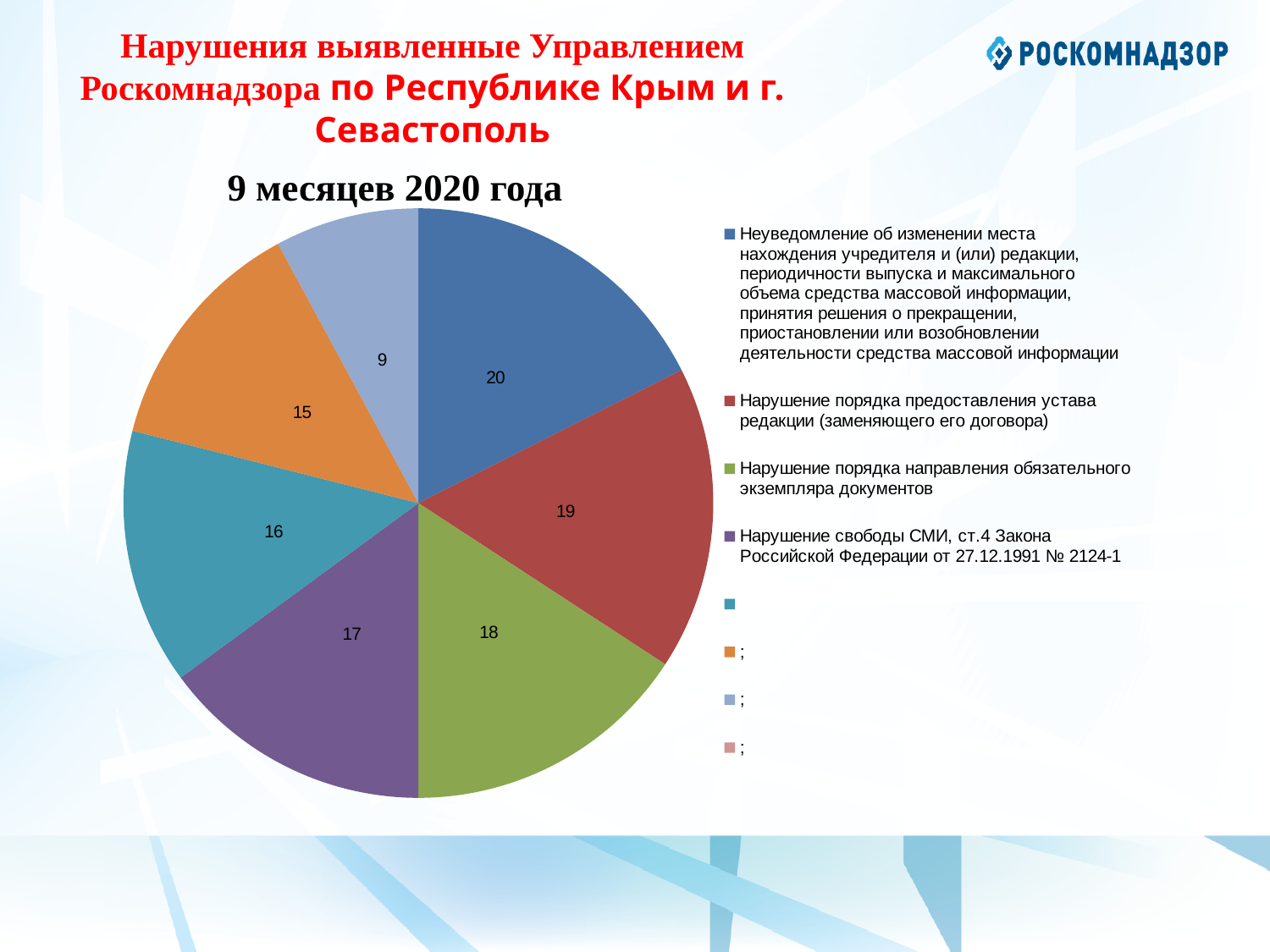
What kind of chart is shown on the slide? Pie chart By how much does the slice for "Нарушение порядка предоставления устава редакции" exceed the slice for "Нарушение свободы СМИ"? 2 What is the value of the slice for "Нарушение порядка направления обязательного экземпляра документов"? 18 How many slices with data labels does the pie chart have? 7 What is the title of the pie chart? 9 месяцев 2020 года What is the largest value shown on the pie chart? 20 What is the value of the slice for "Неуведомление об изменении места нахождения учредителя и (или) редакции..."? 20 What is the value of the slice for "Нарушение свободы СМИ, ст.4 Закона Российской Федерации от 27.12.1991 № 2124-1"? 17 What is the value of the slice for "Нарушение порядка предоставления устава редакции (заменяющего его договора)"? 19 What is the smallest value shown on the pie chart? 9 Which is larger: the slice for "Нарушение порядка предоставления устава редакции" or the slice for "Нарушение свободы СМИ"? Нарушение порядка предоставления устава редакции What is the difference between the largest slice value (20) and the smallest slice value (9)? 11